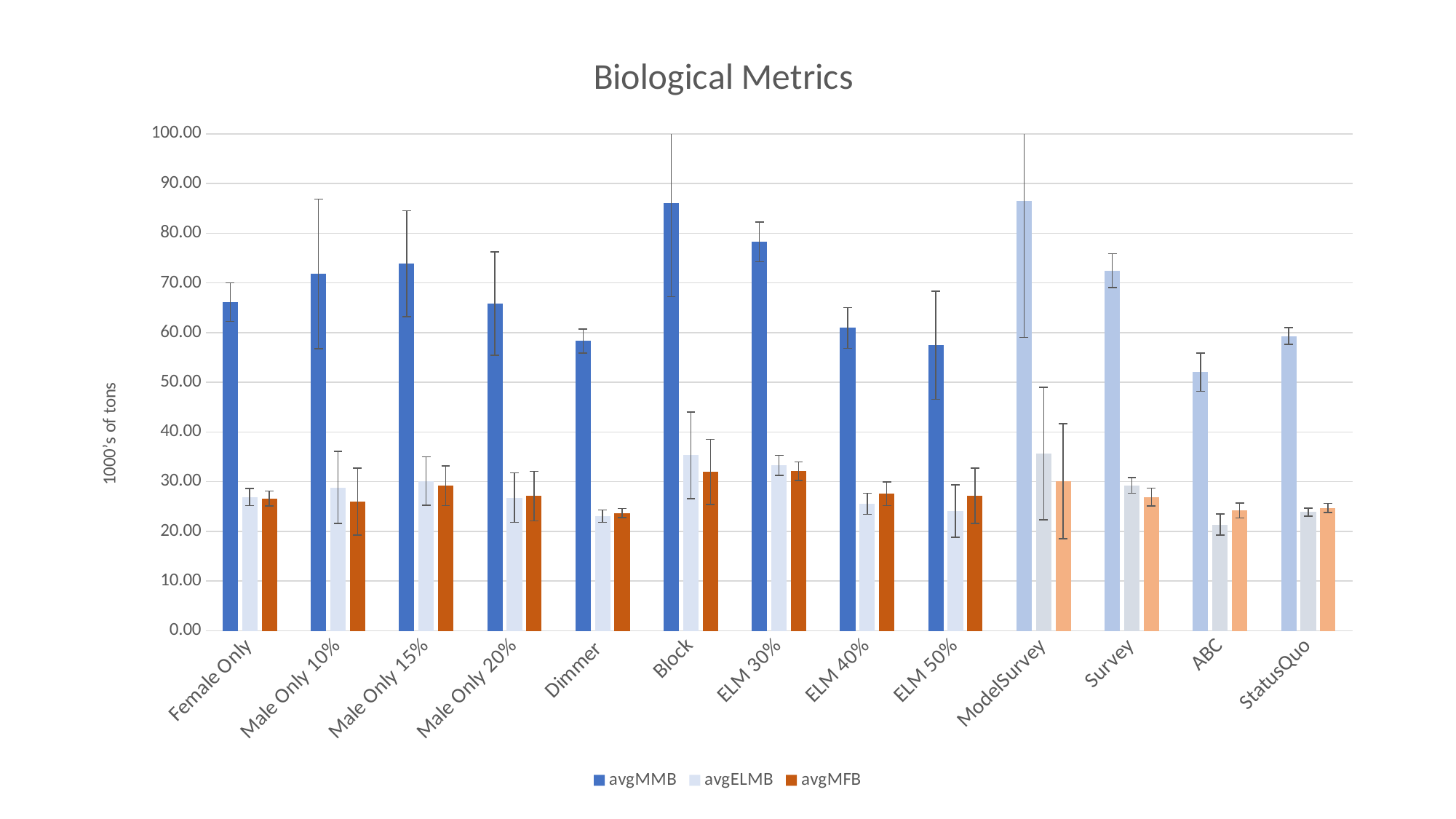
Is the avgMMB value for Block greater or less than 80.00? greater Which category has the lowest avgMMB value? ABC Which is larger, the avgMFB value for Block or for Dimmer? Block What is the label on the vertical axis? 1000's of tons How many categories are shown on the x axis? 13 Is the avgMMB value for Female Only greater or less than 60.00? greater What is the title of the chart? Biological Metrics How many series does the legend list? 3 Is the avgMMB value for Dimmer greater or less than 60.00? less What kind of chart is shown on the slide? bar chart Which is larger, the avgMMB value for Female Only or for Male Only 10%? Male Only 10%